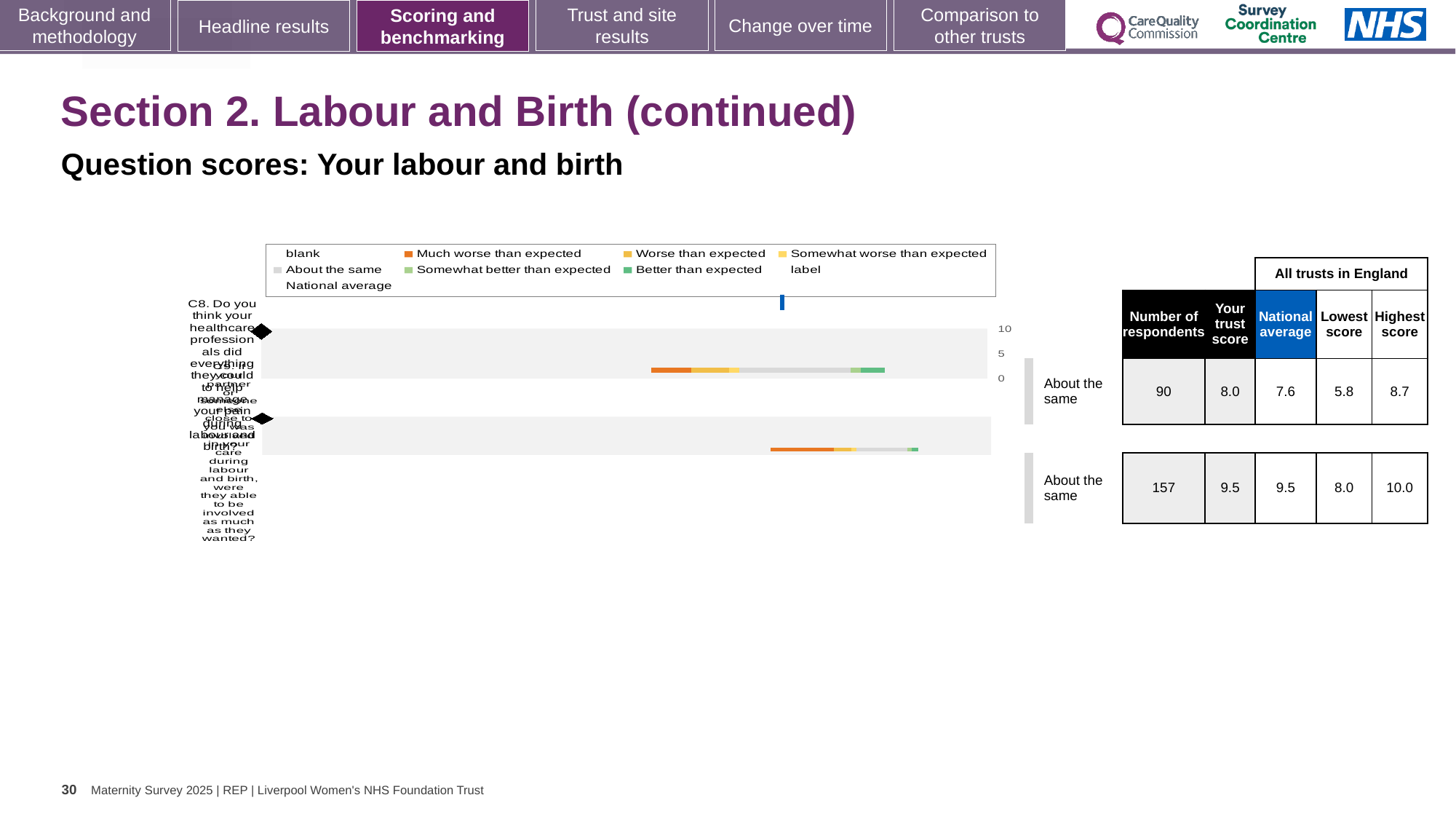
In the chart legend, which colour represents 'Much worse than expected'? orange In the table beside the chart, what is the highest score for the second row? 10.0 What kind of chart is shown on the slide? bar chart How many question rows (bars) are plotted in the chart? 2 What benchmark rating is shown next to the top bar (question C8) in the chart? About the same What benchmark rating is shown next to the second bar in the chart? About the same In the chart legend, what does the blue line marker represent? National average In the table beside the chart, what is the 'Your trust score' for the top row (question C8)? 8.0 In the table beside the chart, how many respondents are listed for the second row? 157 In the table beside the chart, what is the national average for the top row (question C8)? 7.6 In the table beside the chart, what is the difference between the trust score (8.0) and the national average (7.6) for the top row? 0.4 In the table beside the chart, which row has the higher 'Your trust score', the top row (8.0) or the second row (9.5)? the second row